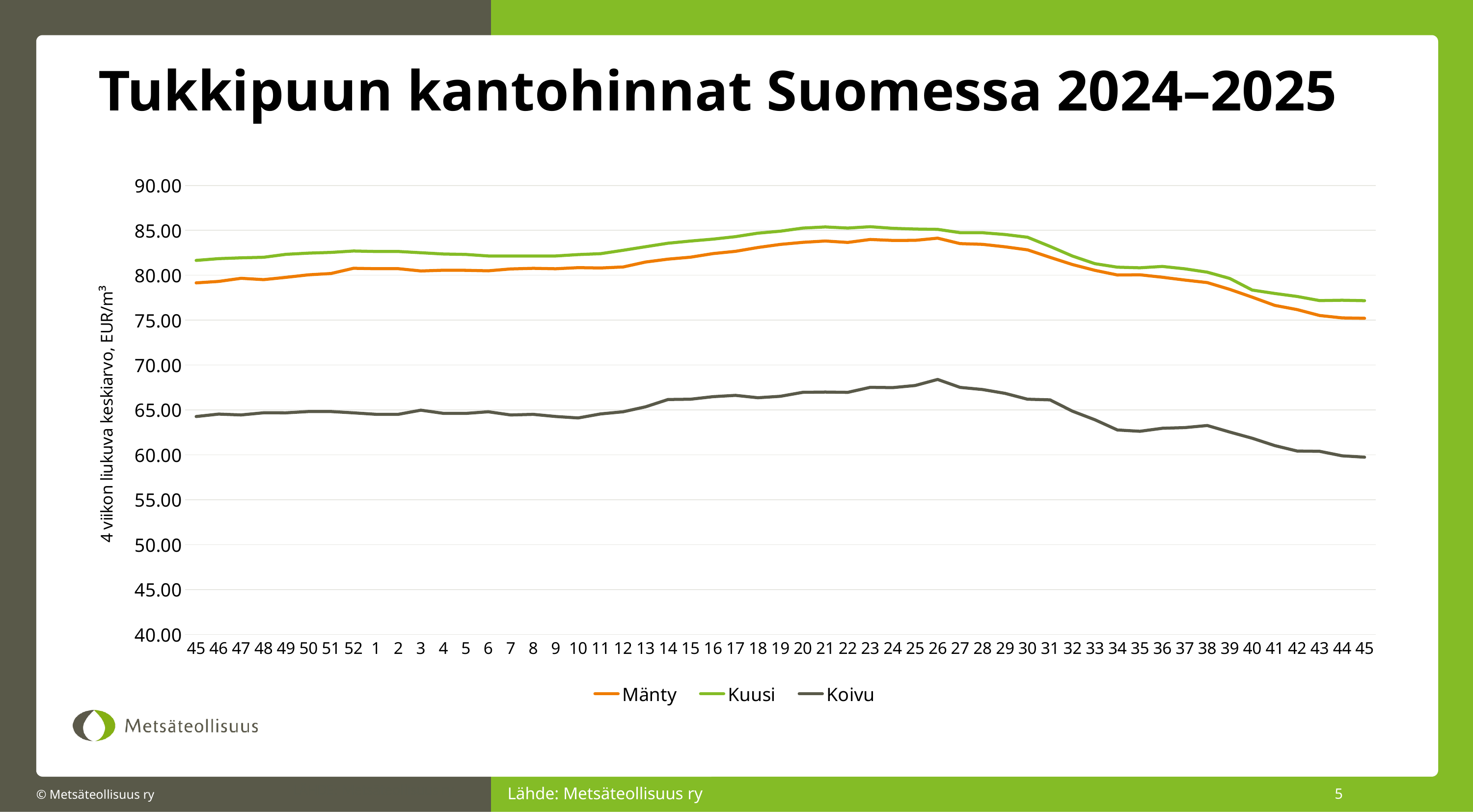
Does the Koivu line rise or fall from week 26 to week 45? fall What kind of chart is shown on the slide? line chart Which series has the highest values across the chart? Kuusi At which week does the Koivu line reach its peak? 26 Is the value for Mänty at week 40 greater or less than 80.00? less Is the value for Koivu at week 42 greater or less than 65.00? less How many series does the legend list? 3 Is the value for Koivu at week 26 greater or less than 65.00? greater Which series has the lowest values across the chart? Koivu Which series are listed in the legend? Mänty, Kuusi, Koivu How many week labels are shown along the x axis? 53 What is the title of the chart on the slide? Tukkipuun kantohinnat Suomessa 2024–2025